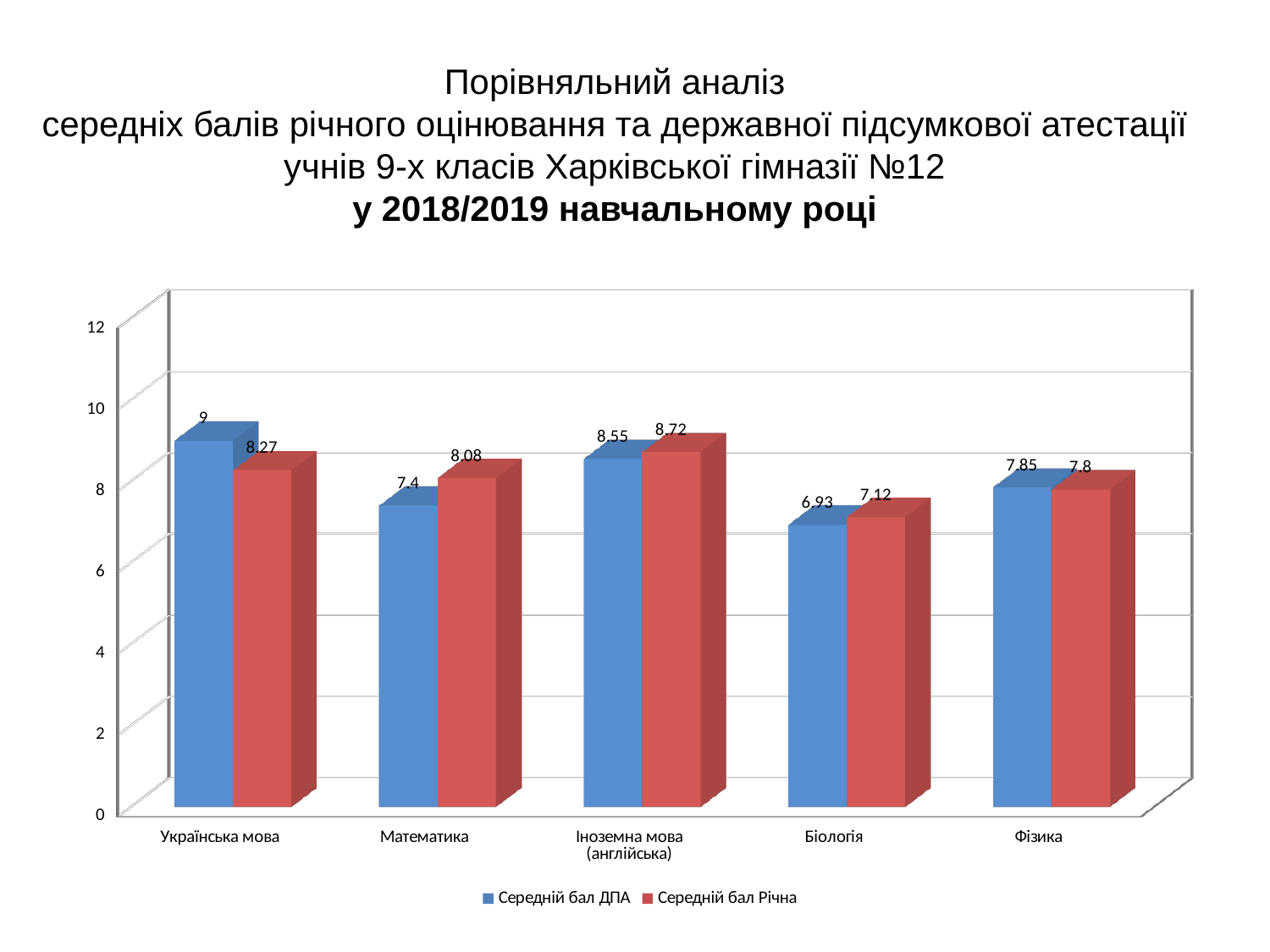
What is the value of Середній бал ДПА for Українська мова? 9 What is the value of Середній бал Річна for Фізика? 7.8 Which subject has the lowest Середній бал Річна? Біологія What kind of chart is shown on the slide? bar chart Is the value of Середній бал ДПА for Іноземна мова (англійська) greater or less than 8? greater How many subjects are shown on the x axis? 5 What is the difference between Середній бал ДПА and Середній бал Річна for Українська мова? 0.73 What is the value of Середній бал Річна for Математика? 8.08 For Математика, which is larger: Середній бал ДПА or Середній бал Річна? Середній бал Річна How many series does the legend list? 2 What is the value of Середній бал ДПА for Біологія? 6.93 Which subject has the highest Середній бал ДПА? Українська мова